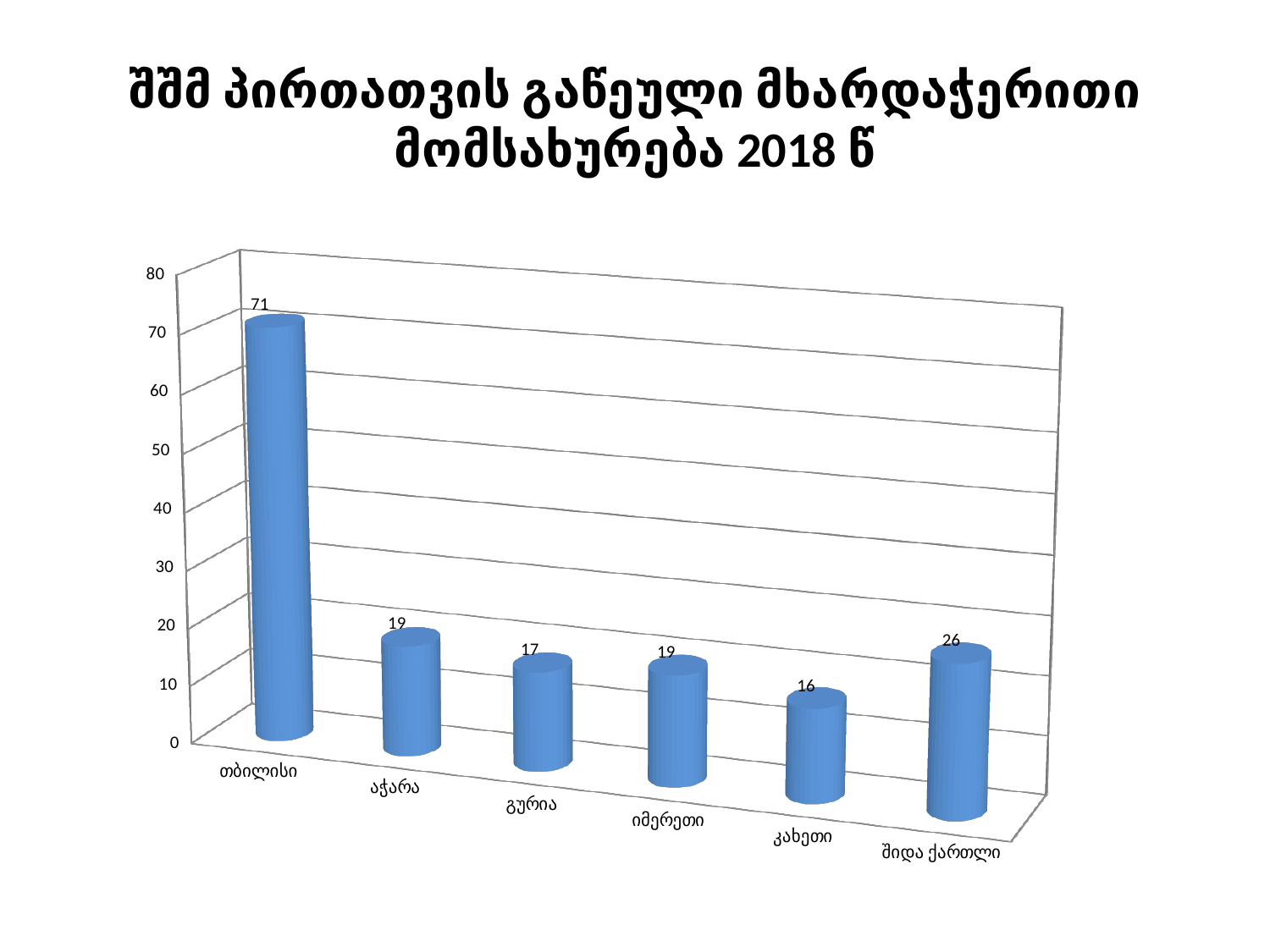
What is the value for გურია? 17 What is the value for შიდა ქართლი? 26 What kind of chart is shown on the slide? bar chart What is the value for თბილისი? 71 What is the value for კახეთი? 16 Which is larger, the value for შიდა ქართლი or the value for აჭარა? შიდა ქართლი How many categories are shown on the x axis? 6 Which category has the lowest value? კახეთი Which category has the highest value? თბილისი What is the difference between the values for თბილისი and შიდა ქართლი? 45 What year is mentioned in the chart title? 2018 Is the value for თბილისი greater or less than 60? greater